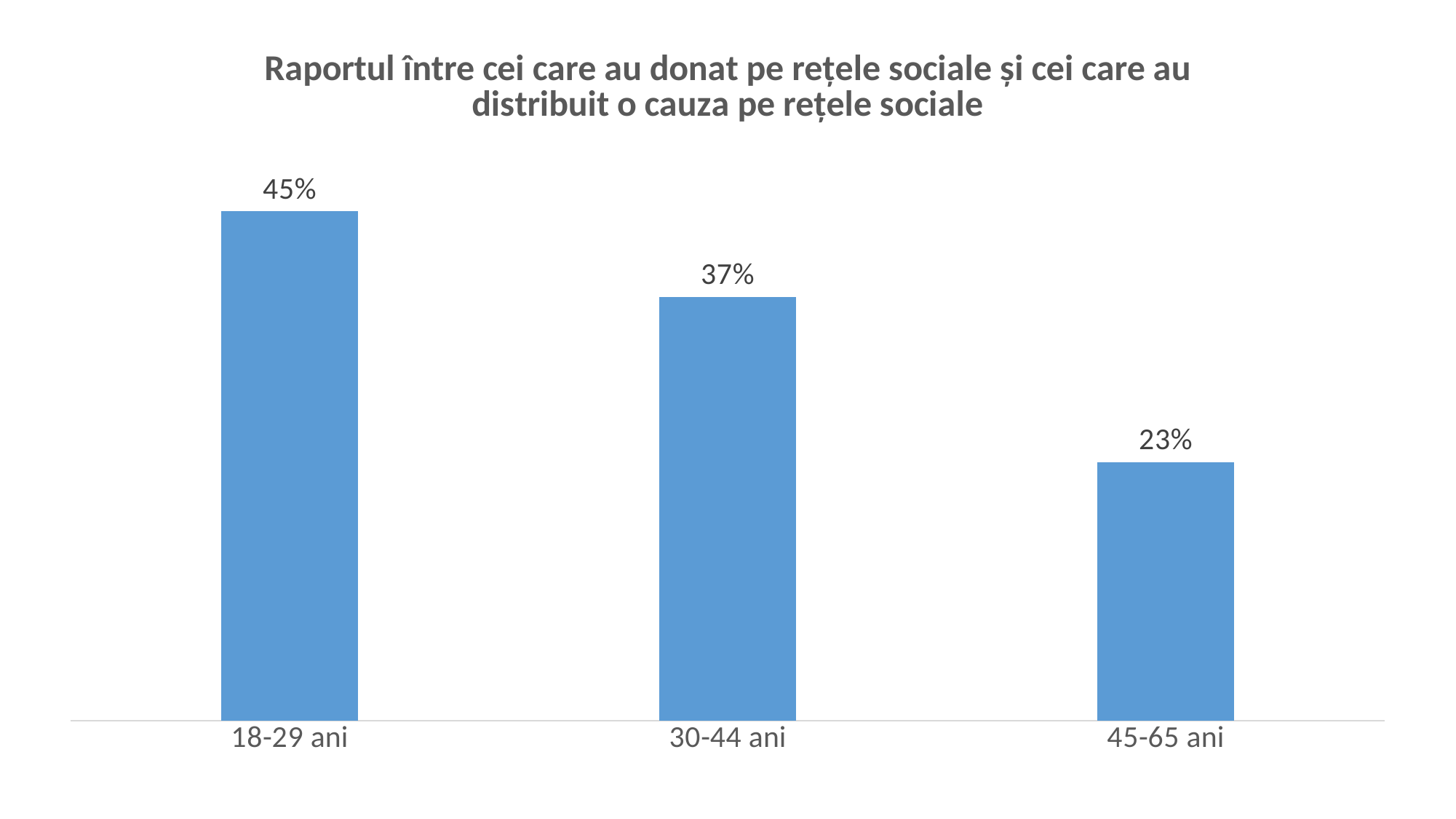
How many age groups are shown in the chart? 3 What is the value for the 45-65 ani age group? 23% What is the difference between the values for 18-29 ani and 45-65 ani? 22% What colour are the bars in the chart? Blue What is the value for the 18-29 ani age group? 45% Which age group has the highest value? 18-29 ani What is the difference between the values for 18-29 ani and 30-44 ani? 8% Do the values rise or fall from the youngest to the oldest age group? Fall What kind of chart is shown on the slide? Bar chart Which age group has the lowest value? 45-65 ani Which is larger, the value for 30-44 ani or the value for 45-65 ani? 30-44 ani What is the value for the 30-44 ani age group? 37%